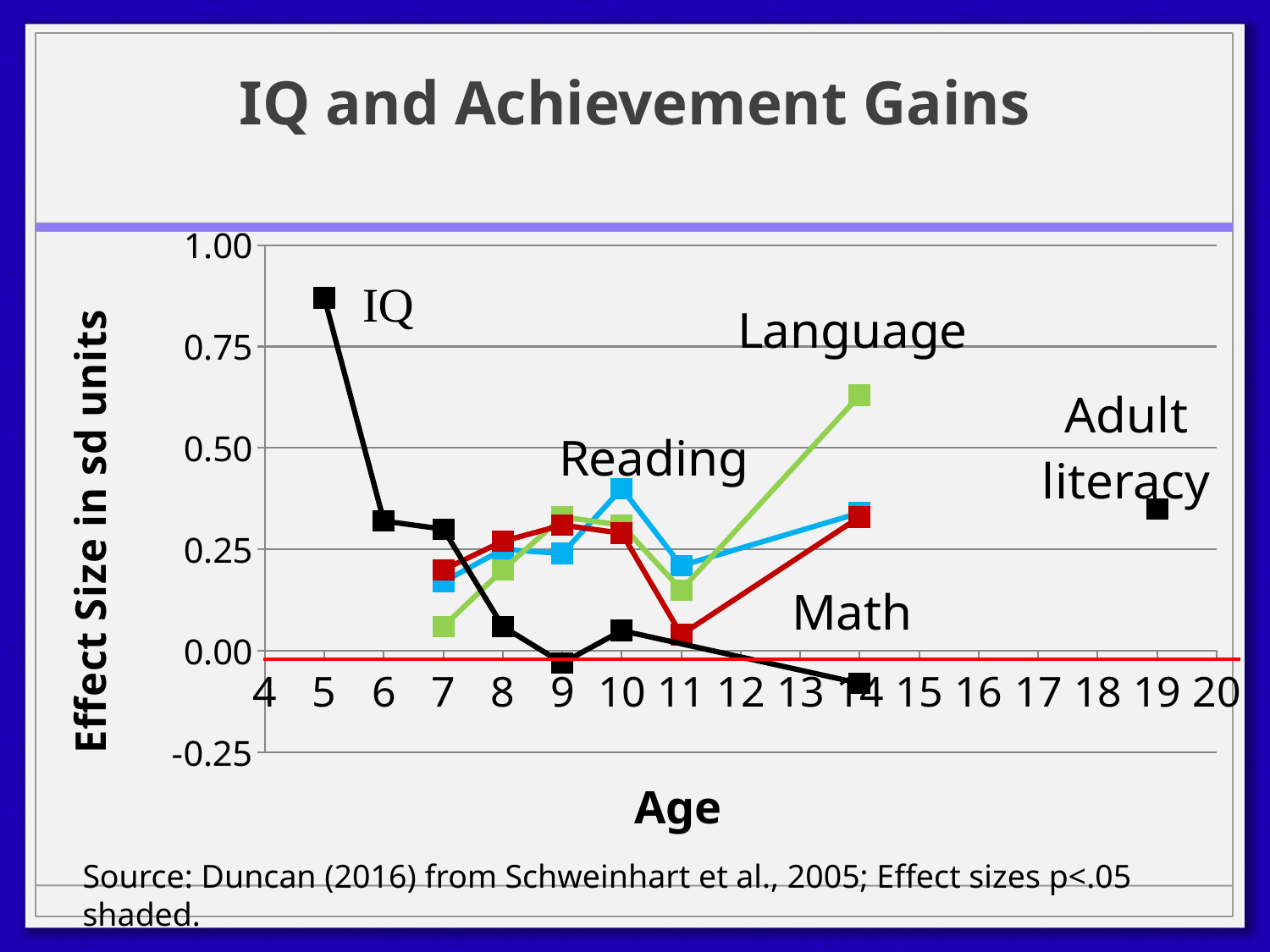
What is the label on the vertical axis of the chart? Effect Size in sd units Is the Math value at age 11 greater or less than 0.25? less Is the Language value at age 14 greater or less than 0.50? greater Is the IQ value at age 5 greater or less than 0.75? greater Does the IQ series rise or fall from age 5 to age 14? fall At age 11, which series has the higher value, Reading or Math? Reading What kind of chart is shown on the slide? line chart At age 14, which series has the higher value, Language or Math? Language At which age does the IQ series reach its highest value? 5 What is the title of the chart? IQ and Achievement Gains